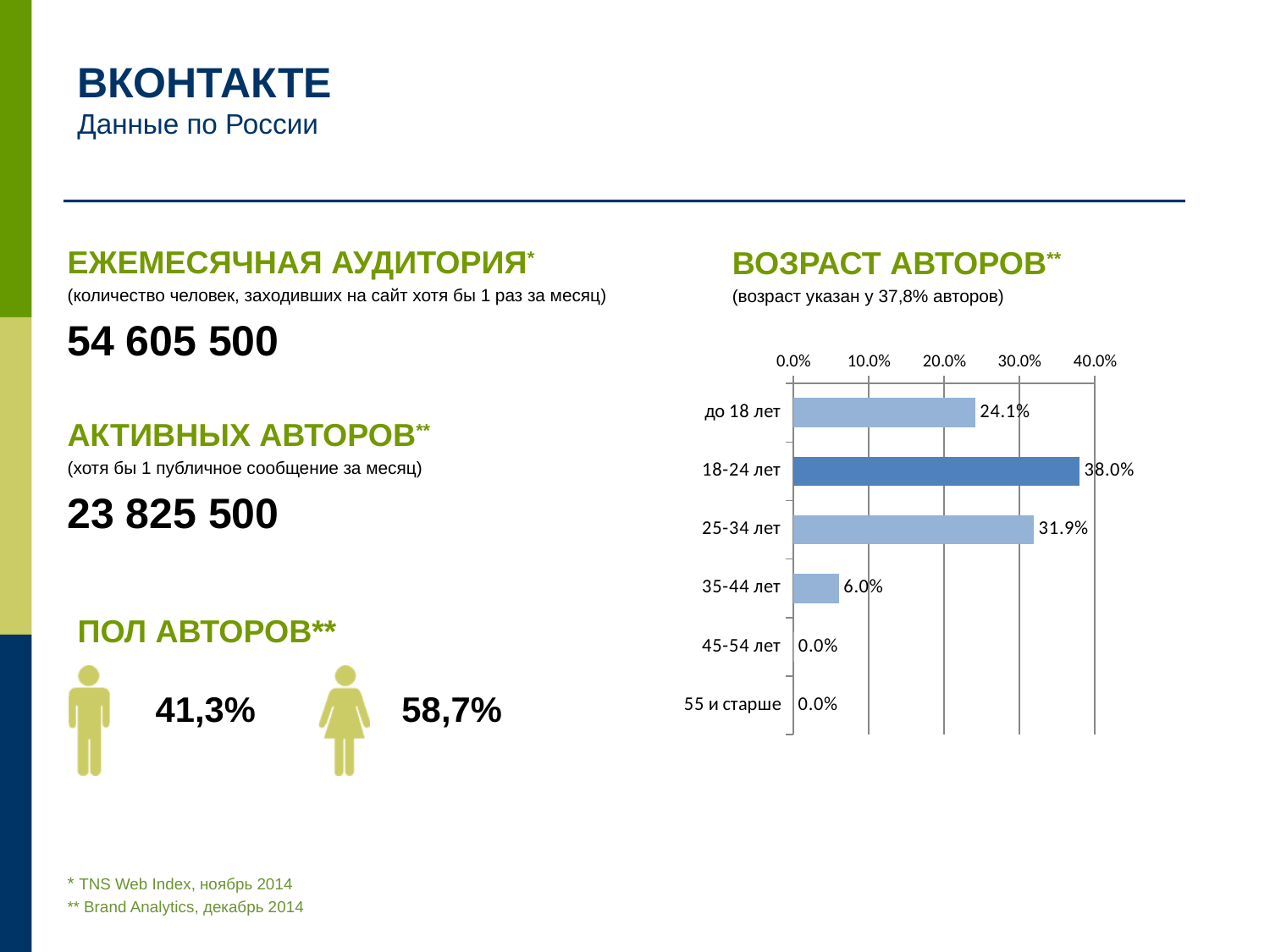
What is the value for the до 18 лет category in the ВОЗРАСТ АВТОРОВ chart? 24.1% What is the highest tick value shown on the axis of the ВОЗРАСТ АВТОРОВ chart? 40.0% In the ВОЗРАСТ АВТОРОВ chart, which is larger: the value for до 18 лет or the value for 25-34 лет? 25-34 лет What is the value for the 35-44 лет category in the ВОЗРАСТ АВТОРОВ chart? 6.0% What is the value for the 45-54 лет category in the ВОЗРАСТ АВТОРОВ chart? 0.0% What is the value for the 18-24 лет category in the ВОЗРАСТ АВТОРОВ chart? 38.0% How many age categories are shown in the ВОЗРАСТ АВТОРОВ chart? 6 Which age category has the highest value in the ВОЗРАСТ АВТОРОВ chart? 18-24 лет What is the difference between the values for 25-34 лет and до 18 лет in the ВОЗРАСТ АВТОРОВ chart? 7.8% What is the difference between the values for 18-24 лет and 25-34 лет in the ВОЗРАСТ АВТОРОВ chart? 6.1% What kind of chart is the ВОЗРАСТ АВТОРОВ chart? Bar chart Is the value for 25-34 лет in the ВОЗРАСТ АВТОРОВ chart greater or less than 30.0%? greater